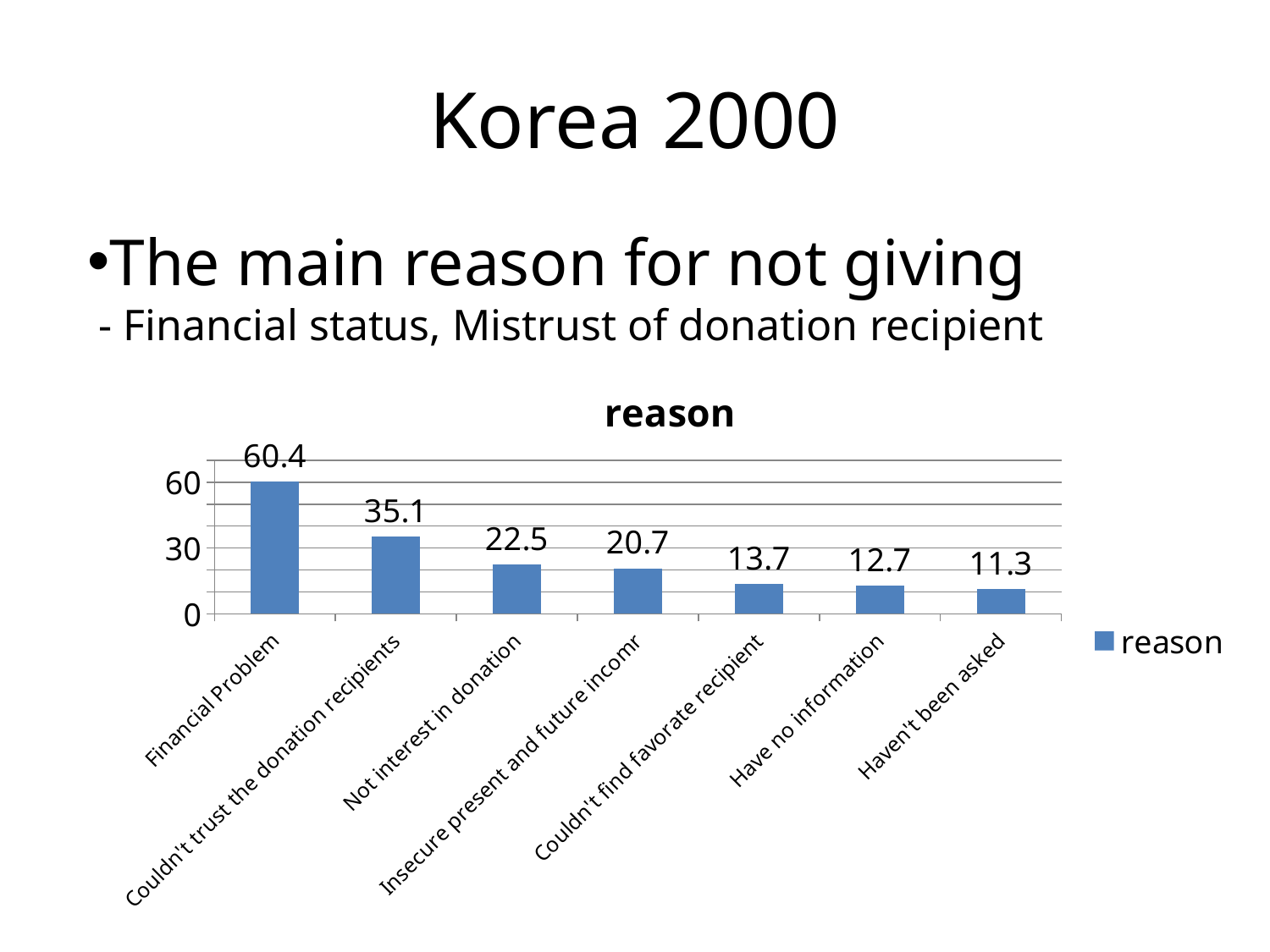
Which is larger, the value for Not interest in donation or the value for Couldn't find favorate recipient? Not interest in donation Which category has the highest value? Financial Problem What is the value for Couldn't trust the donation recipients? 35.1 What is the value for Have no information? 12.7 Which category has the lowest value? Haven't been asked How many categories are shown on the x axis? 7 What is the difference between the values for Financial Problem and Couldn't trust the donation recipients? 25.3 What is the value for Financial Problem? 60.4 What is the title of the chart? reason What is the value for Haven't been asked? 11.3 What kind of chart is shown? bar chart Is the value for Insecure present and future incomr greater or less than 30? less